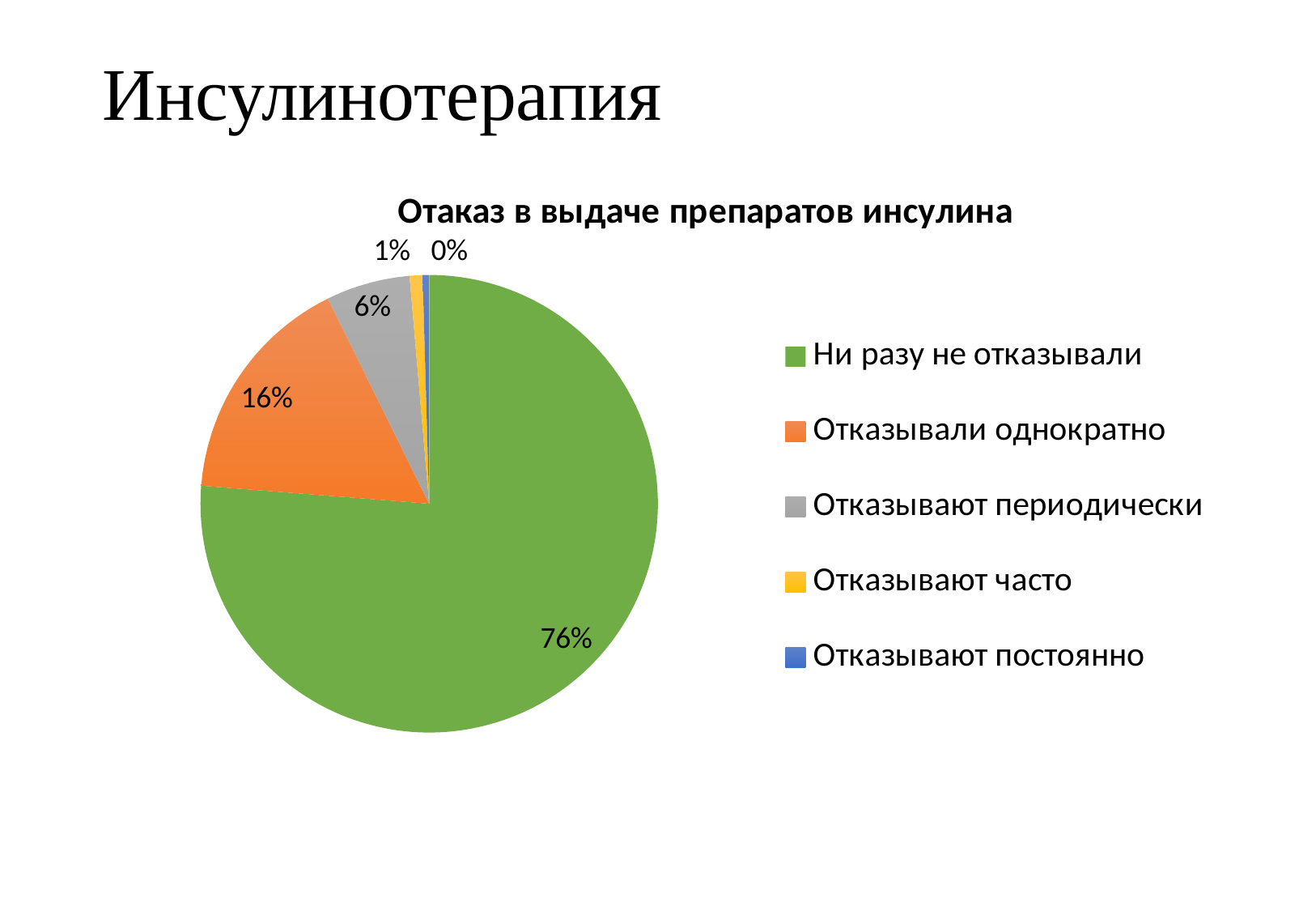
What is the difference between the shares for "Ни разу не отказывали" and "Отказывали однократно"? 60% What kind of chart is shown on the slide? Pie chart What share of the pie does "Отказывали однократно" represent? 16% What share of the pie does "Отказывают периодически" represent? 6% What share of the pie does "Отказывают постоянно" represent? 0% Which category has the smallest slice of the pie? Отказывают постоянно Which is larger: the share for "Отказывали однократно" or for "Отказывают периодически"? Отказывали однократно Which category has the largest slice of the pie? Ни разу не отказывали How many categories does the pie chart show? 5 What is the title of the chart? Отаказ в выдаче препаратов инсулина